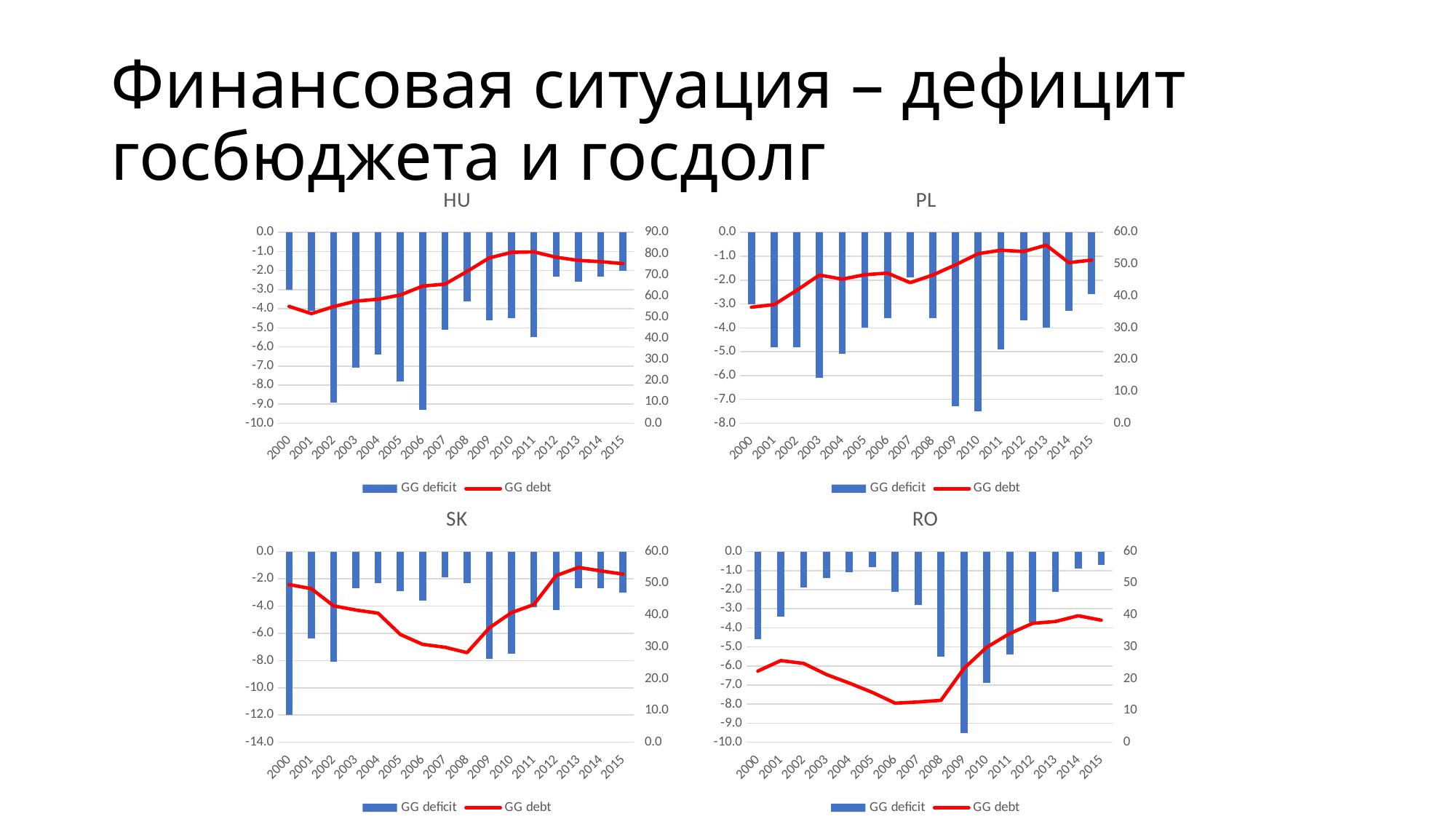
On the SK chart, in which year is the GG deficit bar the largest (most negative)? 2000 On the SK chart, does the GG debt line rise or fall between 2000 and 2008? fall On the HU chart, what kind of chart is it? A combined bar and line chart On the HU chart, is the GG deficit value for 2002 greater or less than -8.0? less On the PL chart, how many series does the legend list? 2 On the HU chart, in which year is the GG deficit bar the largest (most negative)? 2006 On the RO chart, what colour is the GG debt line? Red On the HU chart, does the GG debt line rise or fall between 2000 and 2010? rise On the RO chart, in which year is the GG deficit bar the largest (most negative)? 2009 On the SK chart, how many years are shown on the x axis? 16 On the RO chart, is the GG debt value for 2014 greater or less than 30? greater